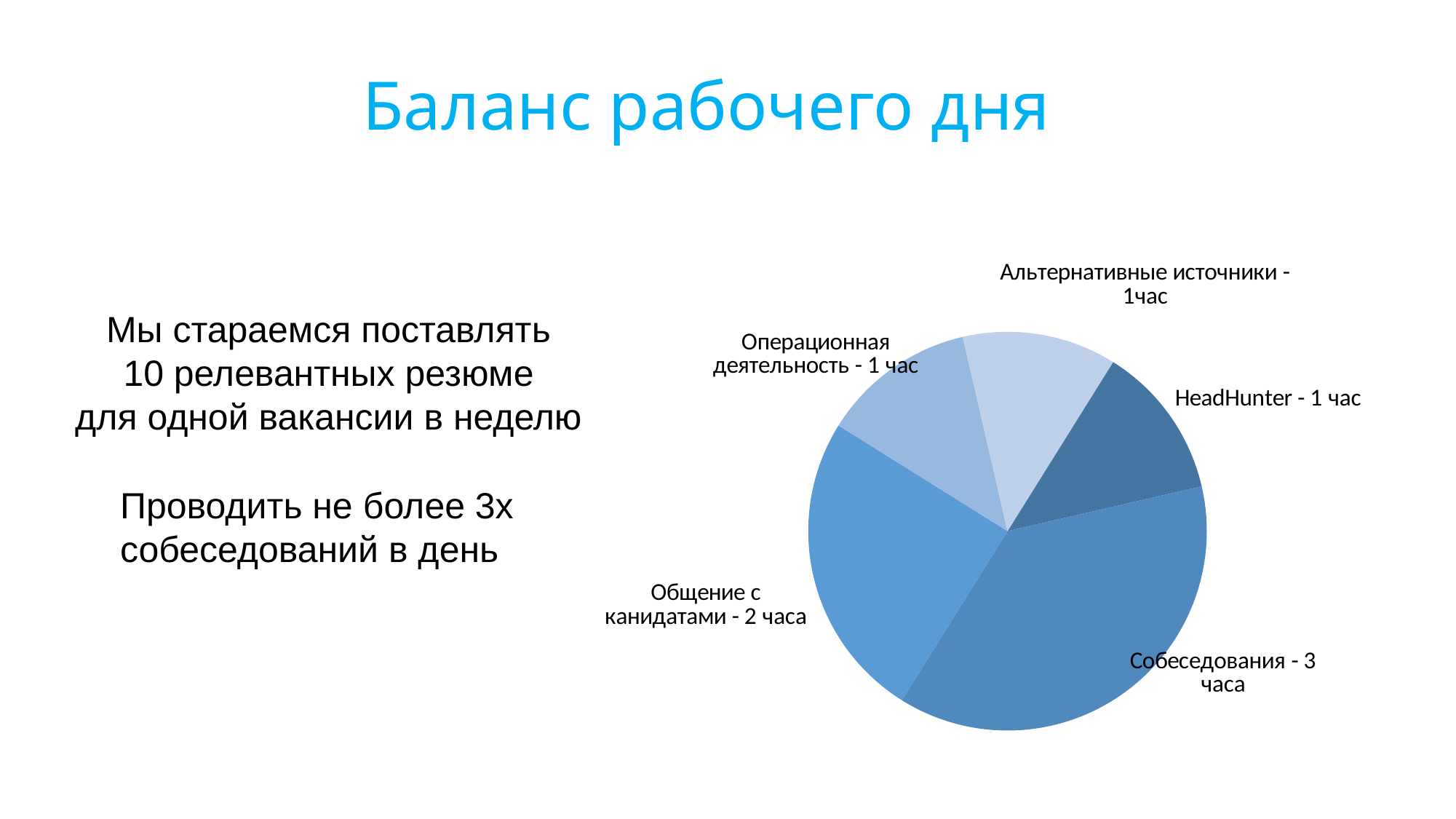
How many hours are allocated to Общение с канидатами? 2 часа What share of the pie does Собеседования represent? 37.5% Which is larger: the time for Собеседования or the time for Общение с канидатами? Собеседования How many hours are allocated to Собеседования in the pie chart? 3 часа What is the total number of hours represented in the pie chart? 8 How many hours are allocated to HeadHunter? 1 час What kind of chart is shown on the slide? Pie chart What share of the pie does Общение с канидатами represent? 25% What is the title of the slide containing the pie chart? Баланс рабочего дня How many slices does the pie chart have? 5 What is the difference in hours between Собеседования and Операционная деятельность? 2 Which category takes the largest share of the working day in the pie chart? Собеседования